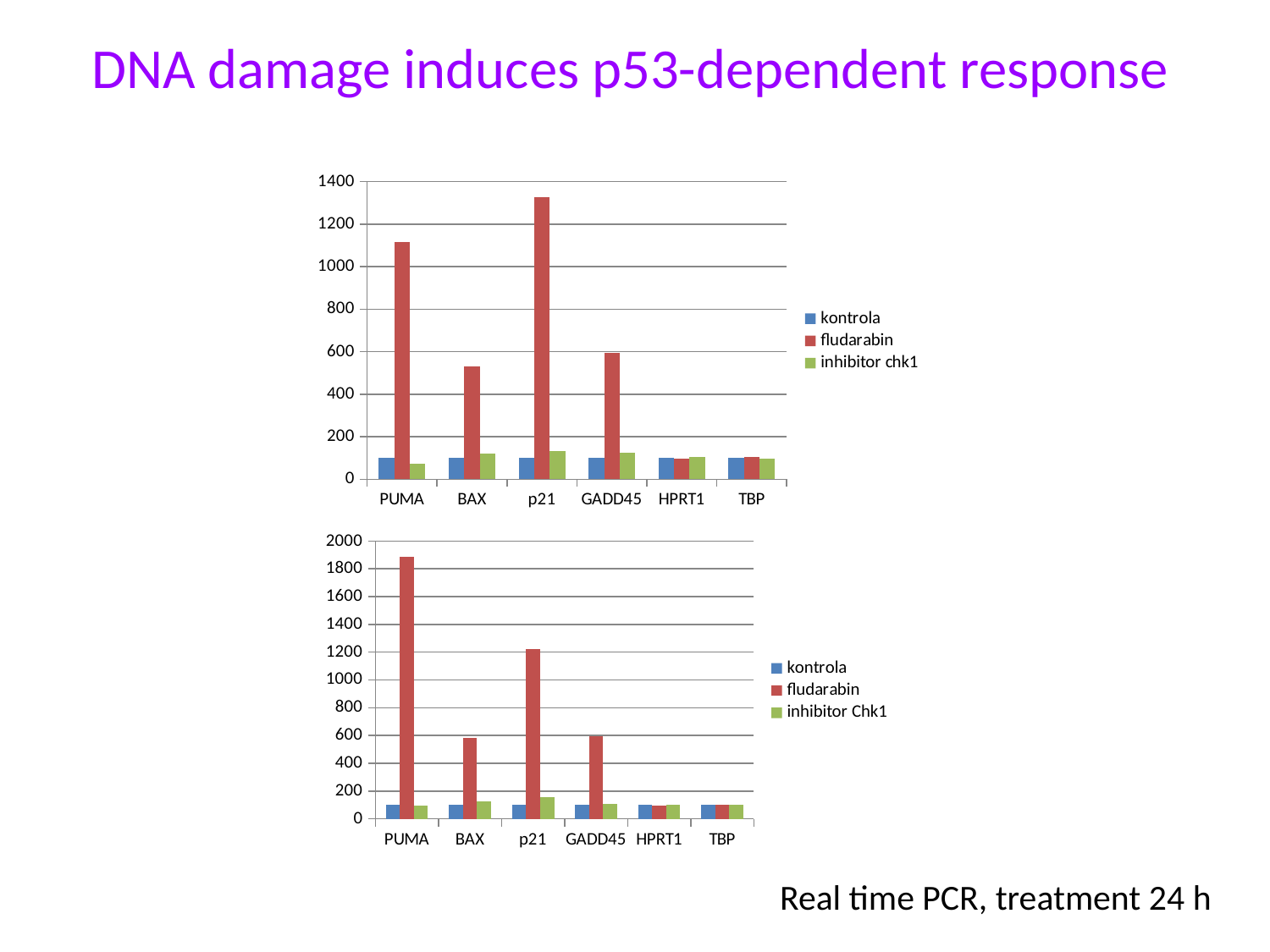
In the top chart, is the fludarabin value for PUMA greater or less than 1000? greater What are the three legend entries of the top chart? kontrola, fludarabin, inhibitor chk1 In the bottom chart, which category has the highest fludarabin value? PUMA In the top chart, which is larger: the fludarabin value for PUMA or the fludarabin value for GADD45? PUMA What kind of chart is the top chart on the slide? bar chart In the bottom chart, is the fludarabin value for p21 greater or less than 1000? greater How many series does the legend of the bottom chart list? 3 In the bottom chart, which is larger: the fludarabin value for p21 or the fludarabin value for BAX? p21 In the top chart, is the fludarabin value for BAX greater or less than 600? less In the top chart, which category has the highest fludarabin value? p21 How many categories are shown on the x axis of the top chart? 6